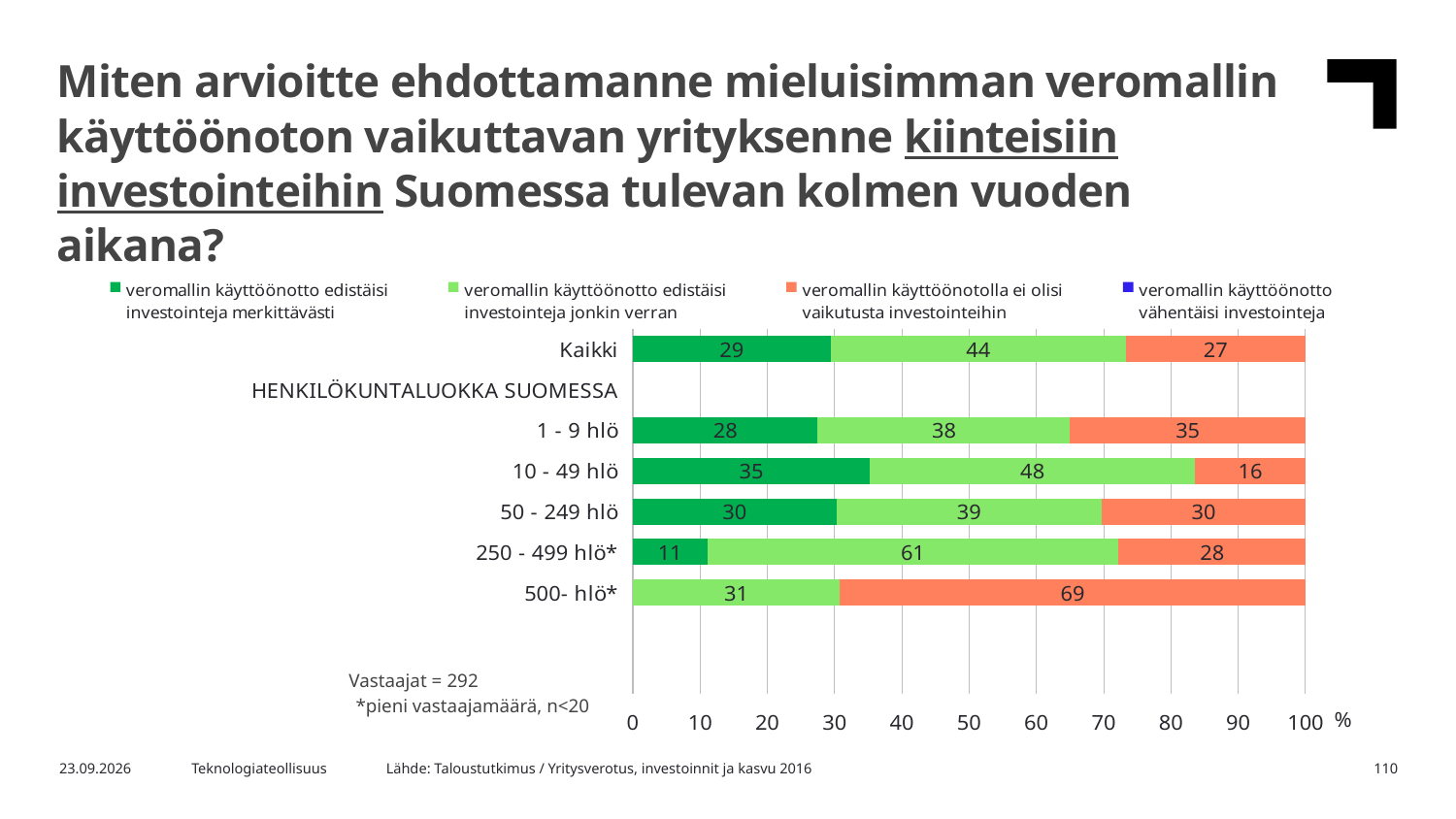
Which category has the lowest value for 'veromallin käyttöönotolla ei olisi vaikutusta investointeihin'? 10 - 49 hlö How many series does the legend list? 4 What is the difference between the 'veromallin käyttöönotolla ei olisi vaikutusta investointeihin' values for 1 - 9 hlö and 10 - 49 hlö? 19 Which is larger: the 'veromallin käyttöönotto edistäisi investointeja merkittävästi' value for 50 - 249 hlö or for 250 - 499 hlö*? 50 - 249 hlö Which category has the highest value for 'veromallin käyttöönotto edistäisi investointeja jonkin verran'? 250 - 499 hlö* What is the total of the stacked bar for Kaikki? 100 What is the number of respondents (Vastaajat) stated on the chart? 292 How many size categories (excluding Kaikki) are plotted under HENKILÖKUNTALUOKKA SUOMESSA? 5 What is the value of 'veromallin käyttöönotto edistäisi investointeja jonkin verran' for Kaikki? 44 What is the value of 'veromallin käyttöönotto edistäisi investointeja merkittävästi' for 10 - 49 hlö? 35 What kind of chart is shown on the slide? stacked bar chart What is the value of 'veromallin käyttöönotolla ei olisi vaikutusta investointeihin' for 500- hlö*? 69